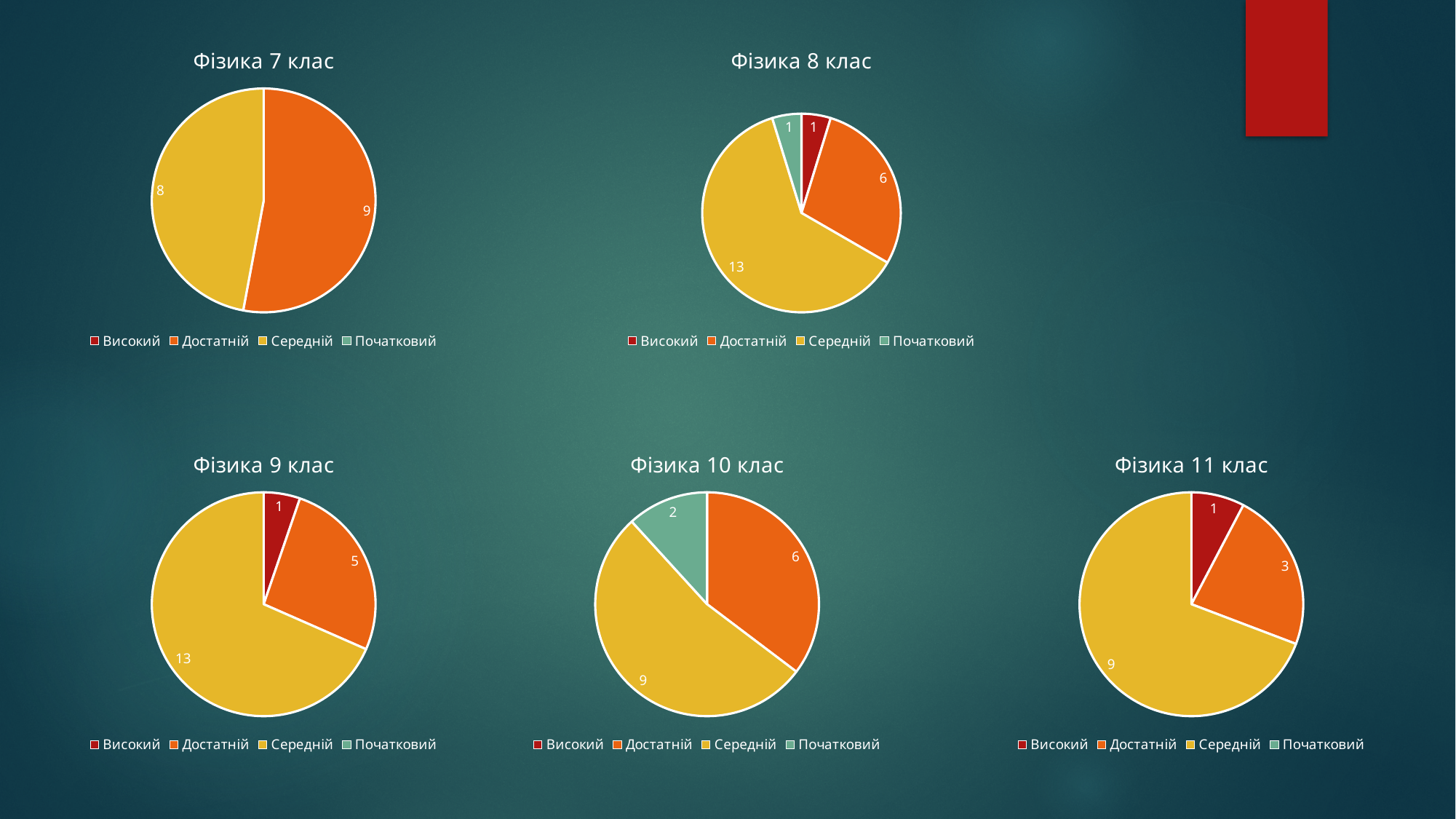
In the 'Фізика 9 клас' chart, which category has the largest slice? Середній In the 'Фізика 8 клас' chart, what is the difference between the Середній and Достатній values? 7 How many entries does the legend of the 'Фізика 8 клас' chart list? 4 In the 'Фізика 7 клас' chart, which is larger, Достатній or Середній? Достатній What type of chart is 'Фізика 11 клас'? Pie chart In the 'Фізика 11 клас' chart, what is the value for Достатній? 3 In the 'Фізика 10 клас' chart, how many slices does the pie have? 3 In the 'Фізика 9 клас' chart, what is the total of all the labelled slices? 19 How many pie charts are shown on the slide? 5 In the 'Фізика 7 клас' chart, what is the value for Достатній? 9 In the 'Фізика 10 клас' chart, what is the value for Початковий? 2 In the 'Фізика 8 клас' chart, what is the value for Середній? 13